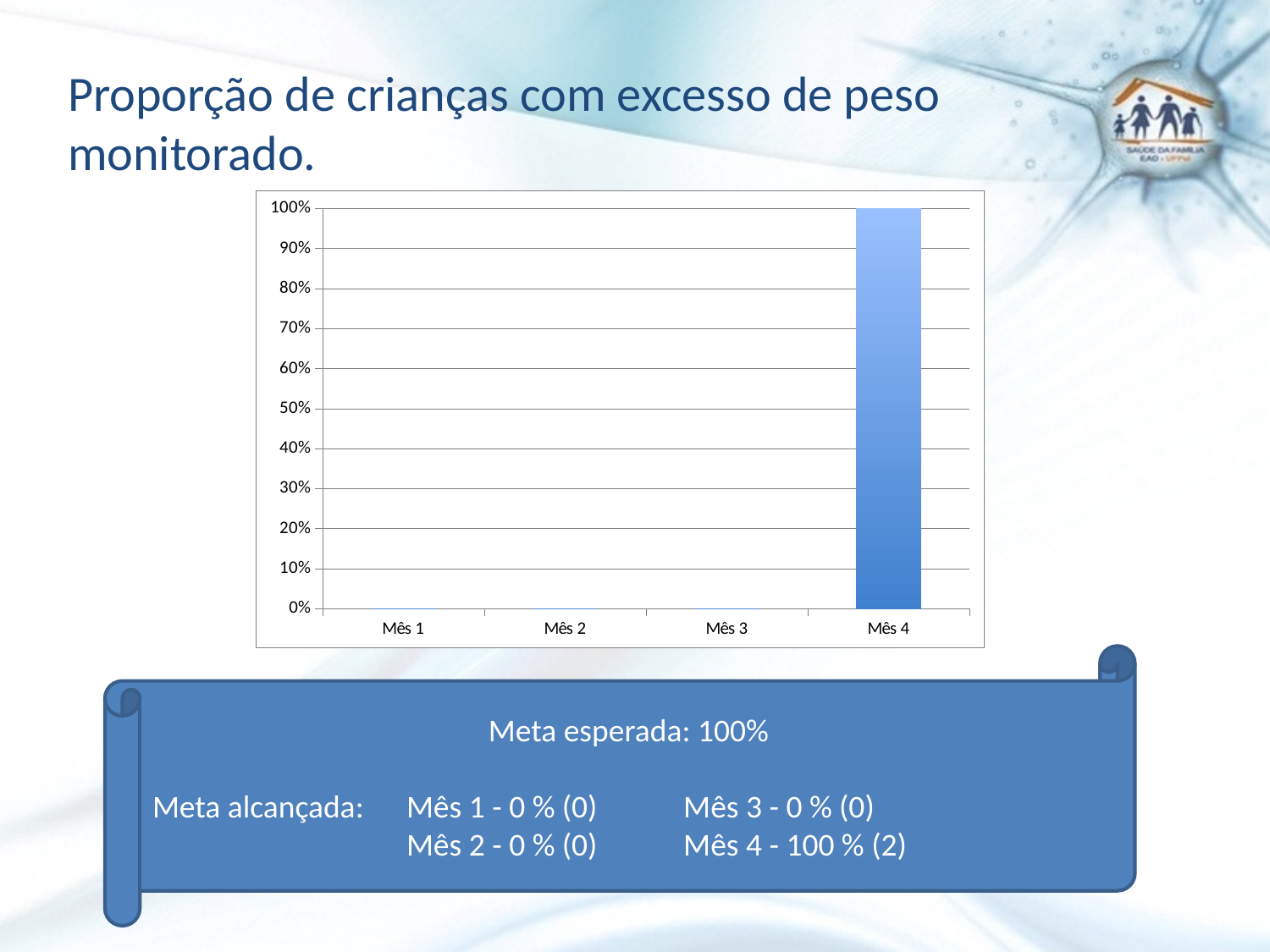
Which month has the highest value in the chart? Mês 4 What is the difference between the values for Mês 4 and Mês 3? 100% What is the value for Mês 1 in the chart? 0% Is the value for Mês 4 greater or less than 50%? greater Do the values rise or fall from Mês 3 to Mês 4? rise Which of Mês 2 and Mês 4 has the larger value? Mês 4 What is the value for Mês 4 in the chart? 100% What is the highest tick shown on the y axis of the chart? 100% What is the title of the slide containing the chart? Proporção de crianças com excesso de peso monitorado. What type of chart is shown on the slide? bar chart What is the value for Mês 3 in the chart? 0% How many categories are shown on the x axis of the chart? 4